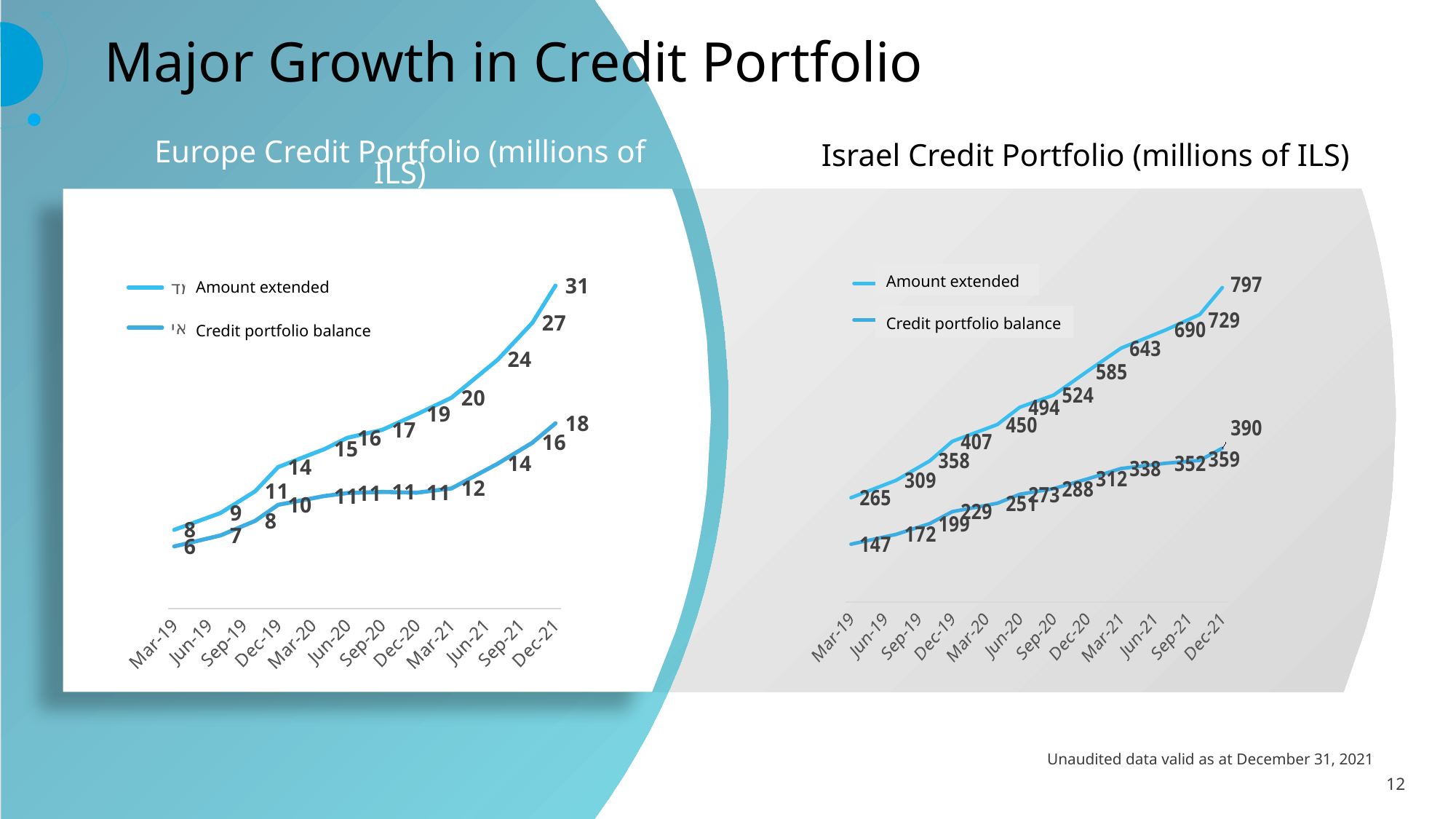
In the Europe Credit Portfolio chart, what is the difference between the Amount extended in Dec-21 and in Mar-19? 23 In the Israel Credit Portfolio chart, what is the Credit portfolio balance for Mar-19? 147 In the Europe Credit Portfolio chart, which period has the highest Credit portfolio balance? Dec-21 In the Europe Credit Portfolio chart, what is the Credit portfolio balance for Mar-19? 6 In the Israel Credit Portfolio chart, what is the Amount extended value for Dec-21? 797 How many series does the legend of the Europe Credit Portfolio chart list? 2 In the Europe Credit Portfolio chart, what is the Amount extended value for Dec-21? 31 In the Israel Credit Portfolio chart, what is the Credit portfolio balance for Dec-21? 390 In the Israel Credit Portfolio chart, what is the difference between the Amount extended and the Credit portfolio balance in Dec-21? 407 In the Israel Credit Portfolio chart, which period has the lowest Amount extended? Mar-19 How many time periods are shown on the x axis of the Israel Credit Portfolio chart? 12 What kind of chart is the Israel Credit Portfolio chart? Line chart